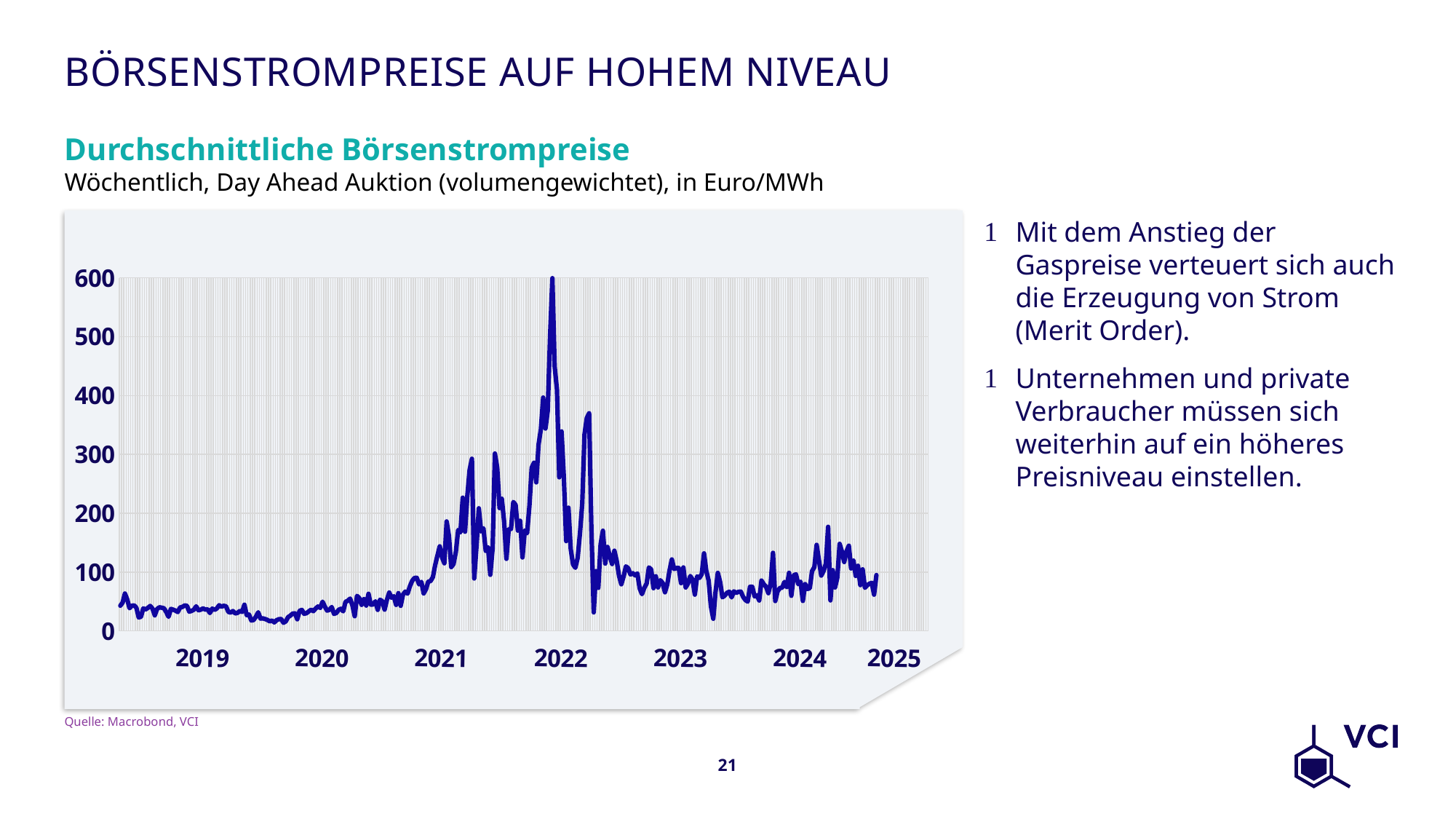
Are the values during 2019 greater or less than 100? less Is the value at the end of the line near 2025 greater or less than 200? less What kind of chart is shown on the slide? line chart How many year labels are shown on the x axis of the chart? 7 Do the values rise or fall from the peak near 2022 to 2023? fall Which period shows higher prices, 2019 or 2024? 2024 What is the highest value shown on the y axis of the chart? 600 Do the values rise or fall from 2019 to the peak near 2022? rise Is the peak value of the line greater or less than 500? greater What is the title of the chart? Durchschnittliche Börsenstrompreise In what unit are the values of the chart given? Euro/MWh Around which year label does the line reach its highest point? 2022